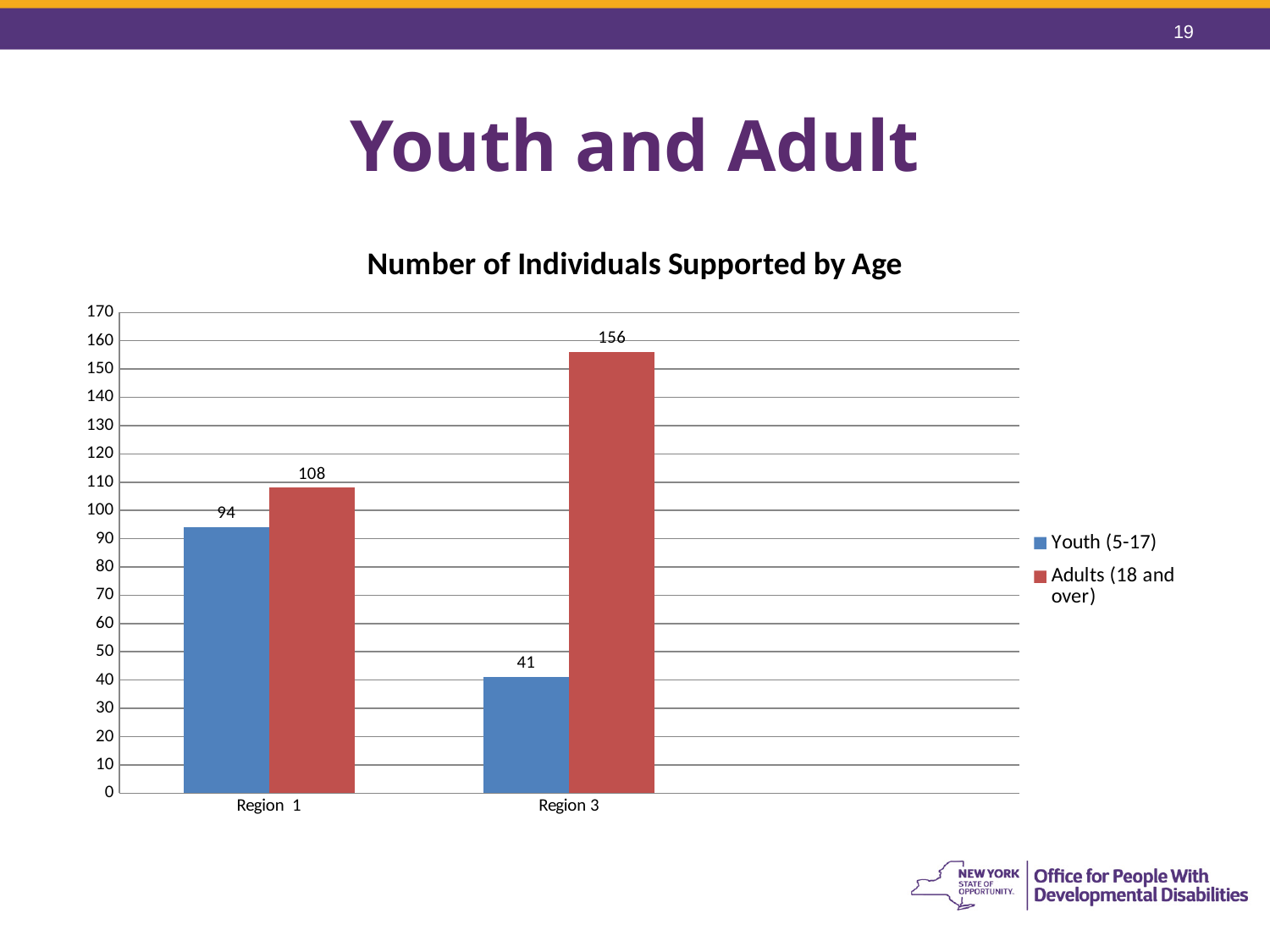
How many regions are shown on the x axis? 2 What is the difference between the Adults (18 and over) value and the Youth (5-17) value in Region 3? 115 Which region has the highest value for Adults (18 and over)? Region 3 What kind of chart is shown on the slide? Bar chart How many series does the legend list? 2 Which region has the lowest value for Youth (5-17)? Region 3 What is the title of the chart? Number of Individuals Supported by Age What is the value for Adults (18 and over) in Region 1? 108 What is the value for Adults (18 and over) in Region 3? 156 What is the value for Youth (5-17) in Region 1? 94 Which is larger in Region 1: the Youth (5-17) value or the Adults (18 and over) value? Adults (18 and over) What is the value for Youth (5-17) in Region 3? 41